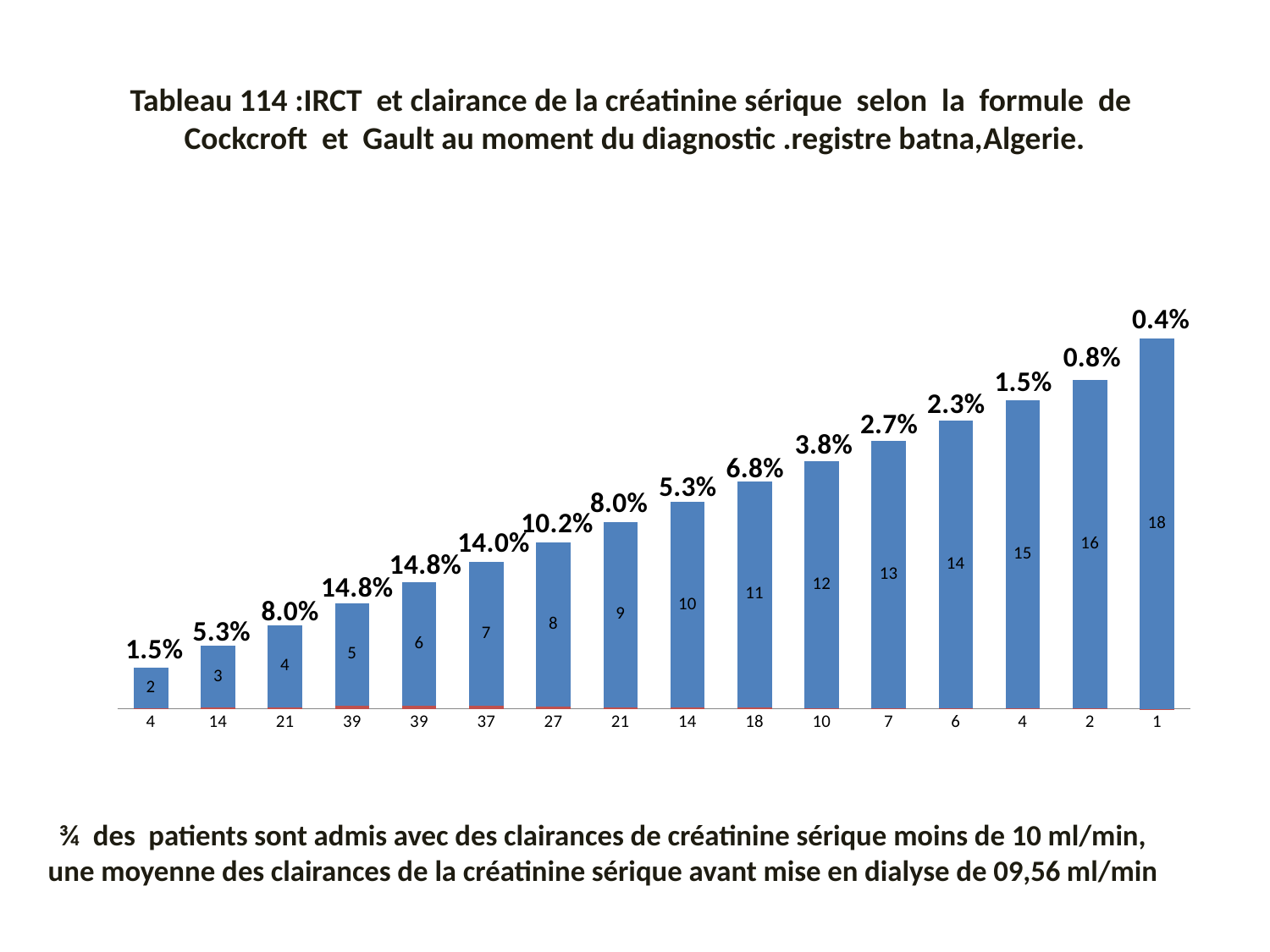
What is the difference between the percentage above the bar labeled 8 (10.2%) and the percentage above the bar labeled 9 (8.0%)? 2.2% What kind of chart is shown on the slide? bar chart How many bars does the chart contain? 16 What percentage is printed above the bar labeled 18 inside it? 0.4% What is the lowest percentage label shown above any bar? 0.4% Which has the larger percentage label above it: the bar labeled 10 or the bar labeled 11? the bar labeled 11 What is the highest percentage label shown above any bar? 14.8% What percentage is printed above the bar labeled 11 inside it? 6.8% What x-axis label appears beneath the bar labeled 10 inside it? 14 Do the bar heights rise or fall from left to right across the chart? rise What is the number of the 'Tableau' given in the chart title? 114 What percentage is printed above the bar labeled 5 inside it? 14.8%